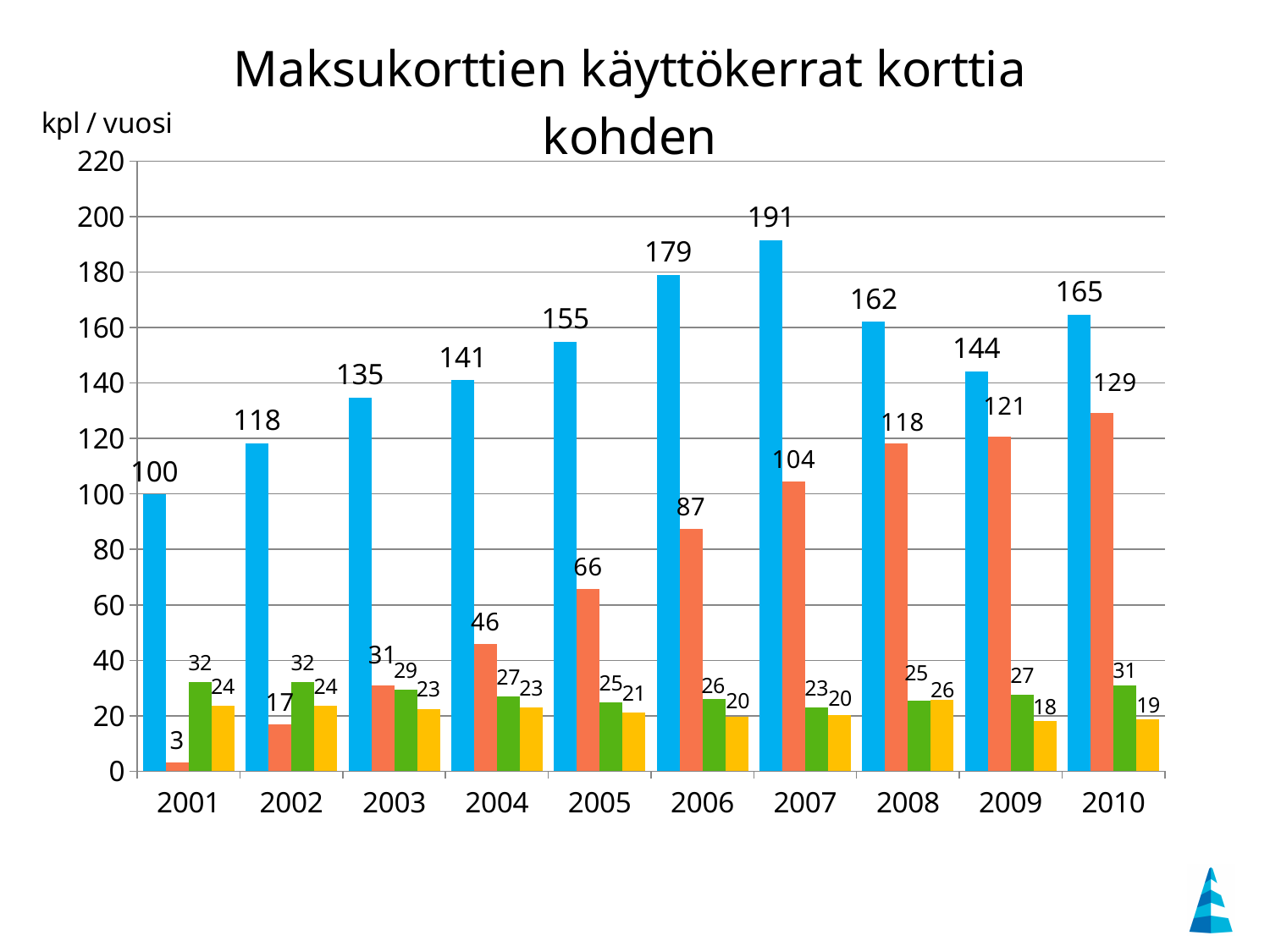
What is the title of the chart? Maksukorttien käyttökerrat korttia kohden Which is larger in 2009, the green bar or the yellow bar? the green bar How many years are shown on the x axis? 10 In which year is the orange bar lowest? 2001 Is the value of the blue bar for 2006 greater or less than 160? greater Does the orange series rise or fall from 2001 to 2010? rise What is the value of the green bar for 2005? 25 What kind of chart is shown on the slide? bar chart In which year is the blue bar highest? 2007 What is the value of the blue bar for 2007? 191 What is the value of the orange bar for 2010? 129 What is the difference between the blue bar and the orange bar in 2008? 44